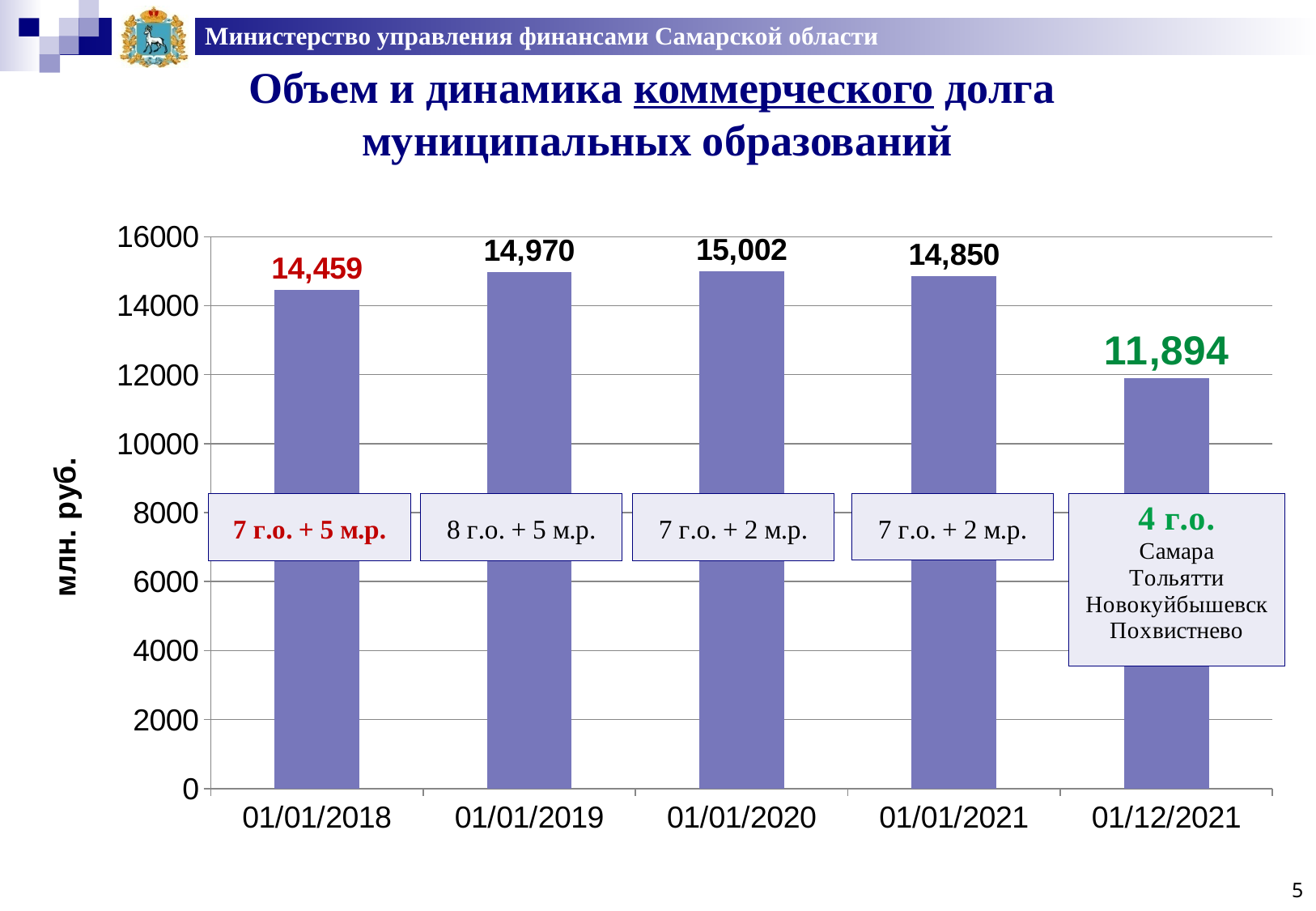
Which date has the lowest value? 01/12/2021 What is the value for 01/12/2021? 11,894 Is the value for 01/12/2021 greater or less than 12000? less What is the value for 01/01/2021? 14,850 What is the difference between the values for 01/01/2021 and 01/12/2021? 2,956 Which is larger, the value for 01/01/2019 or the value for 01/01/2021? 01/01/2019 How many bars are shown in the chart? 5 What is the difference between the values for 01/01/2019 and 01/01/2018? 511 What kind of chart is shown on the slide? bar chart Which date has the highest value? 01/01/2020 What is the label of the vertical axis? млн. руб. What is the value for 01/01/2018? 14,459